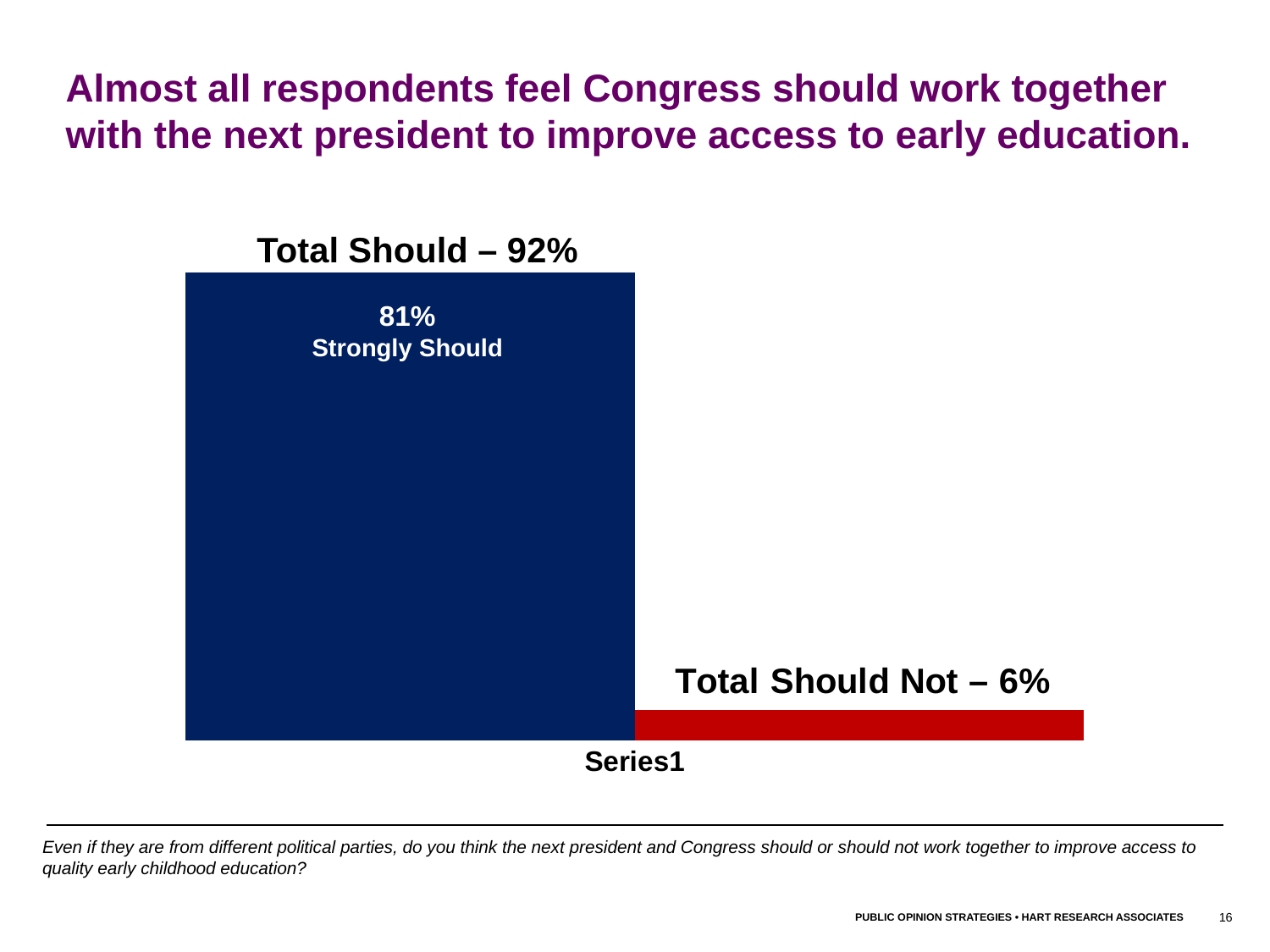
What colour is the Total Should Not bar? Red What is the value shown for Total Should Not? 6% Which bar is the shortest? Total Should Not Which is larger, Total Should or Total Should Not? Total Should Which bar is the tallest? Total Should What is the value shown for Total Should? 92% What kind of chart is shown on the slide? Bar chart What is the difference between Total Should (92%) and Total Should Not (6%)? 86 percentage points What percentage of respondents say Congress and the next president Strongly Should work together? 81% What is the difference between Total Should (92%) and Strongly Should (81%)? 11 percentage points What label appears on the horizontal axis beneath the bars? Series1 How many bars are plotted in the chart? 2